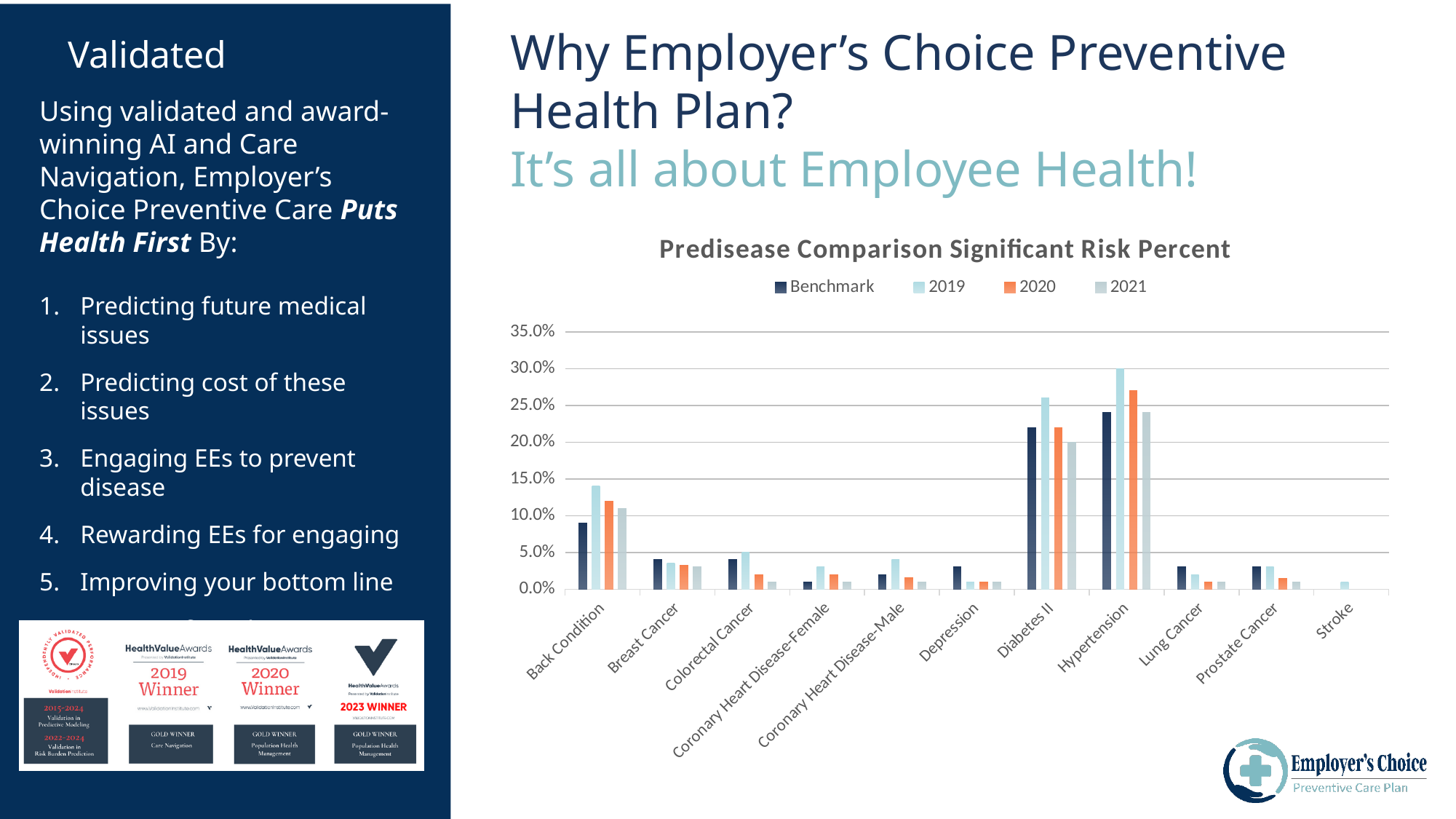
How many series does the chart legend list? 4 Is the Benchmark value for Breast Cancer greater or less than 5.0%? less What kind of chart is shown on the slide? Bar chart How many condition categories are shown on the x axis of the chart? 11 What is the title of the chart? Predisease Comparison Significant Risk Percent Which condition has the lowest values overall in the chart? Stroke For Back Condition, which is larger: the 2019 value or the 2020 value? 2019 Is the 2019 value for Back Condition greater or less than 10.0%? greater Which series are listed in the chart legend? Benchmark, 2019, 2020, 2021 Which condition has the highest Benchmark value in the chart? Hypertension Is the 2019 value for Hypertension greater or less than 25.0%? greater Which condition has the highest 2019 value in the chart? Hypertension